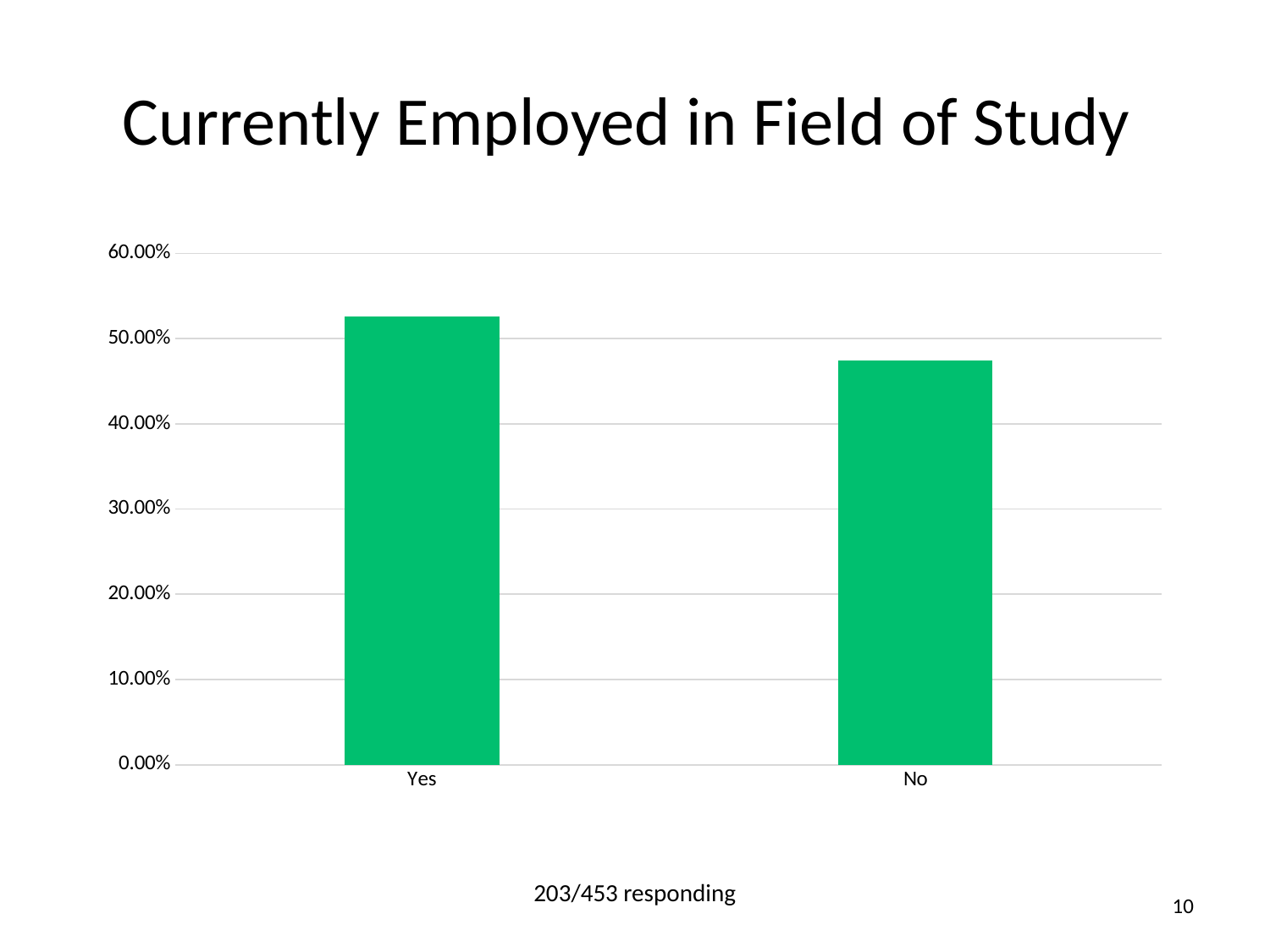
What kind of chart is shown on the slide? bar chart Is the value for Yes greater or less than 50.00%? greater Is the value for No greater or less than 50.00%? less What is the highest value shown on the y axis? 60.00% Which category has the highest value? Yes Which category has the lowest value? No What is the title of the slide? Currently Employed in Field of Study Is the value for No greater or less than 40.00%? greater What colour are the bars in the chart? green How many categories are shown on the x axis? 2 Which is larger, the value for Yes or the value for No? Yes